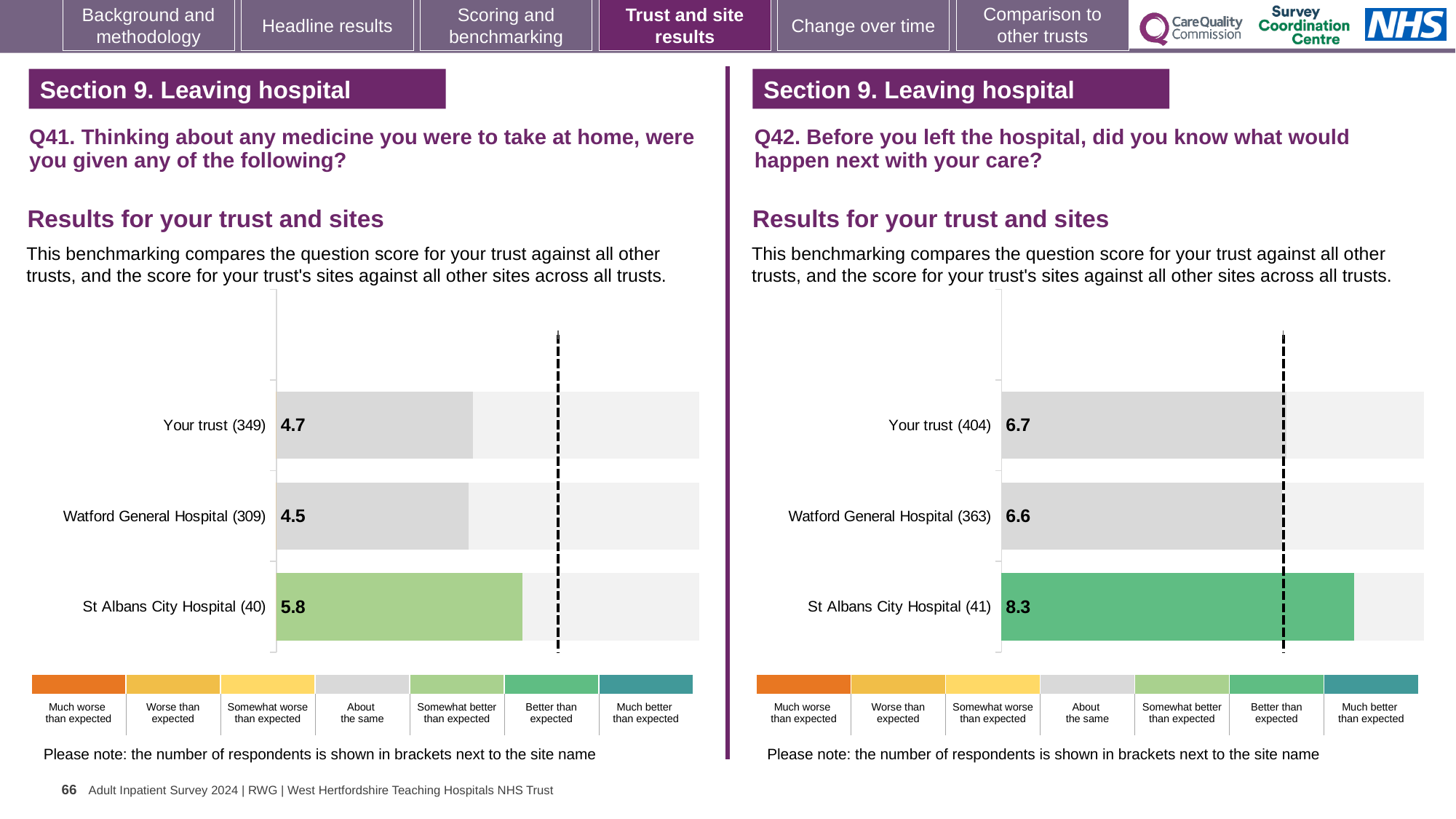
In the Q42 chart on the right, what is the score for St Albans City Hospital? 8.3 In the Q41 chart on the left, which site or trust has the highest score? St Albans City Hospital In the Q42 chart on the right, which benchmark category does the colour of the St Albans City Hospital bar correspond to? Better than expected In the Q41 chart on the left, what is the difference between the scores for St Albans City Hospital and Watford General Hospital? 1.3 In the Q41 chart on the left, what is the score for Your trust? 4.7 In the Q42 chart on the right, how many bars are plotted? 3 What kind of chart is used in the Q41 chart on the left? Bar chart In the Q42 chart on the right, what is the score for Watford General Hospital? 6.6 In the Q42 chart on the right, which site or trust has the highest score? St Albans City Hospital In the Q41 chart on the left, what is the score for St Albans City Hospital? 5.8 In the Q42 chart on the right, what is the difference between the scores for St Albans City Hospital and Your trust? 1.6 In the Q41 chart on the left, which site or trust has the lowest score? Watford General Hospital